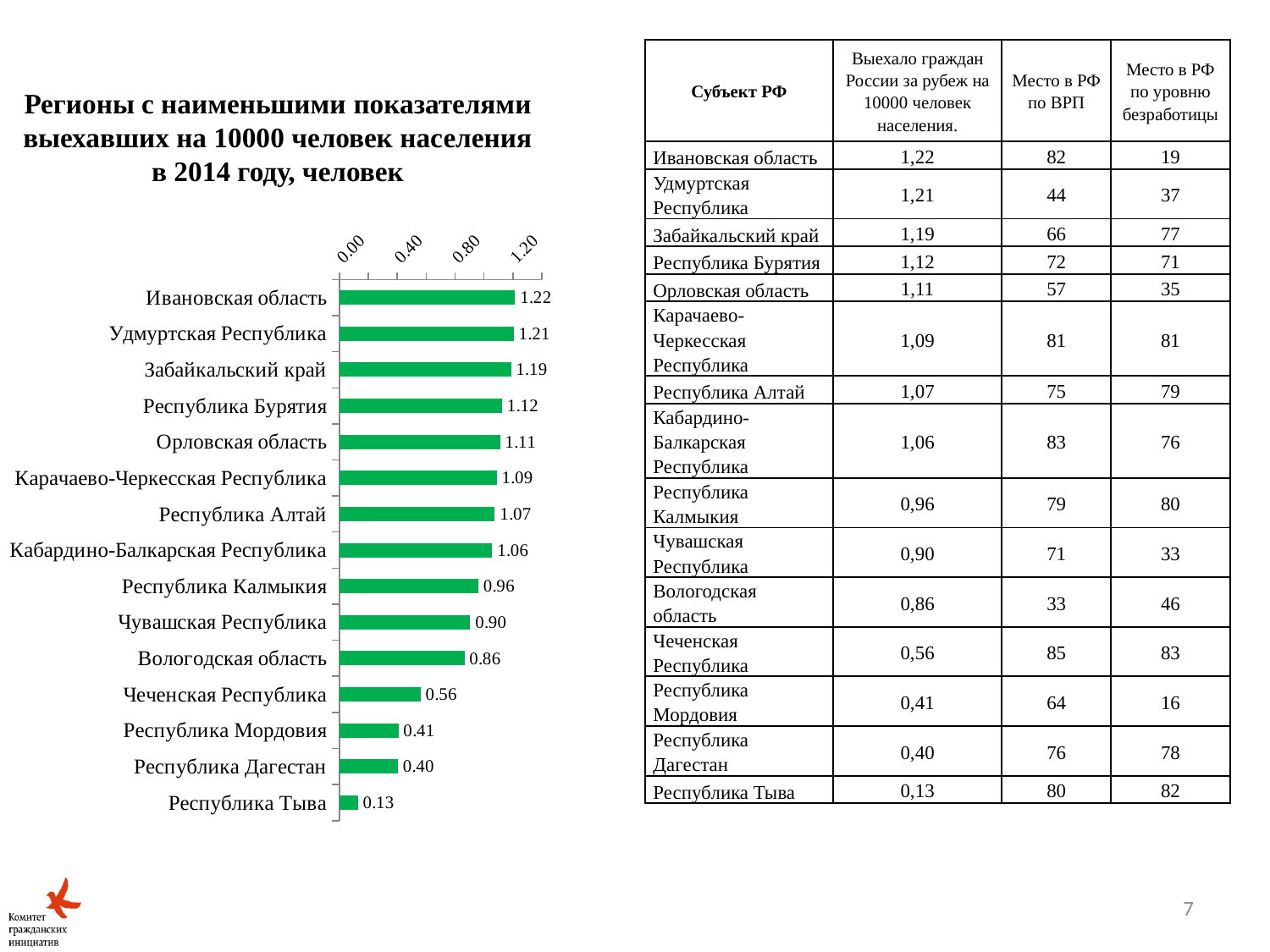
Do the bar values increase or decrease going from the top of the chart to the bottom? decrease What kind of chart is shown on the slide? bar chart Which region has the highest value in the bar chart? Ивановская область What is the difference between the values for Ивановская область and Республика Тыва? 1.09 What is the value for Чеченская Республика in the bar chart? 0.56 What is the value for Ивановская область in the bar chart? 1.22 Is the value for Республика Тыва greater or less than 0.40? less What is the value for Республика Калмыкия in the bar chart? 0.96 Which is larger: the value for Вологодская область or the value for Чеченская Республика? Вологодская область How many regions are plotted in the bar chart? 15 What is the title of the bar chart? Регионы с наименьшими показателями выехавших на 10000 человек населения в 2014 году, человек Which region has the lowest value in the bar chart? Республика Тыва